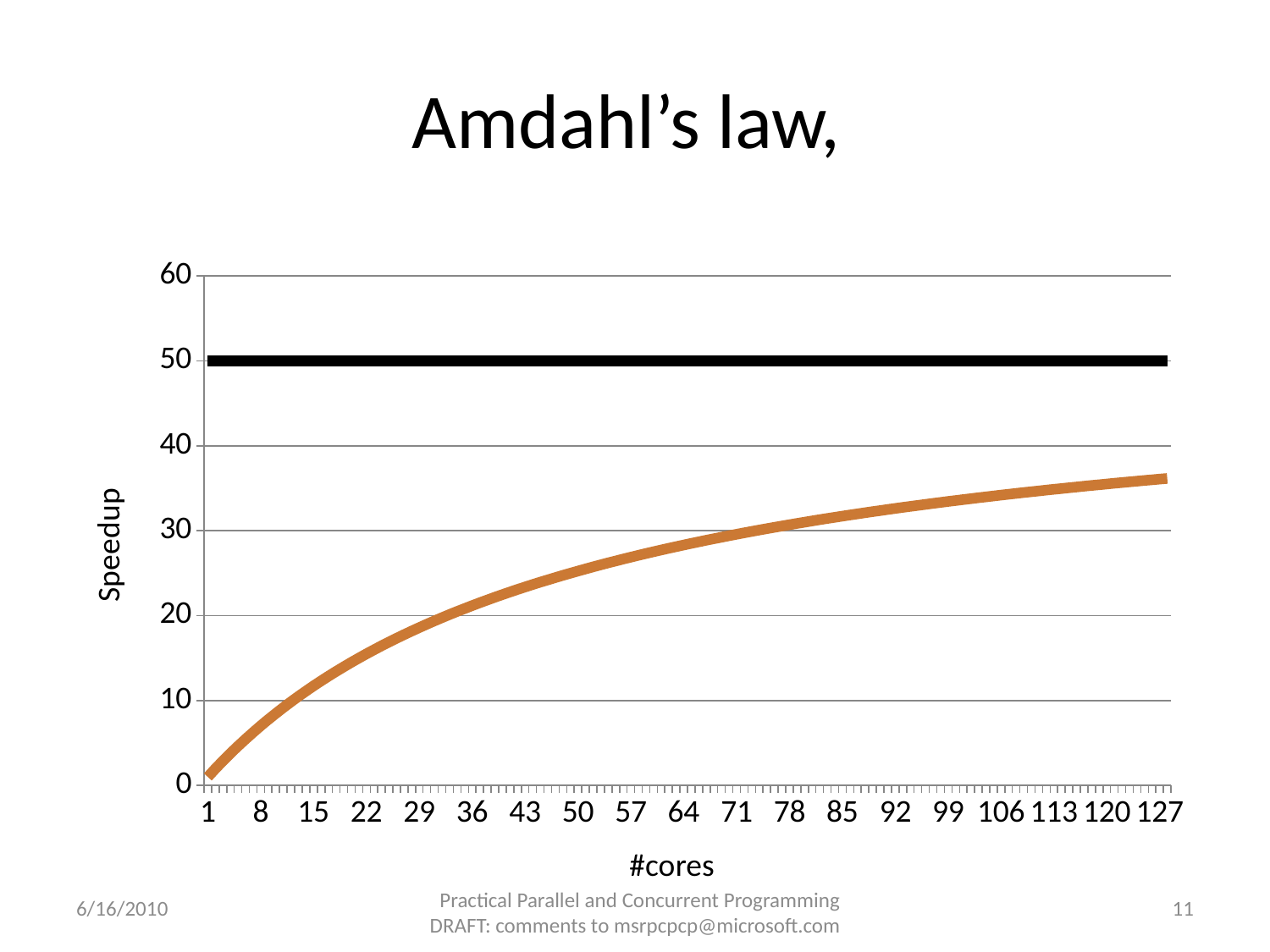
Is the value of the orange line at 50 cores greater or less than 20? greater Is the value of the orange line at 127 cores greater or less than 40? less What kind of chart is shown on the slide? line chart At what speedup value does the flat black line sit? 50 How many lines are plotted on the chart? 2 Is the value of the orange line at 8 cores greater or less than 10? less At 127 cores, which line is higher, the black line or the orange line? the black line What is the label of the vertical axis? Speedup Does the orange line rise or fall as the number of cores increases? rise What is the highest value shown on the vertical axis? 60 What is the title of the chart? Amdahl's law,